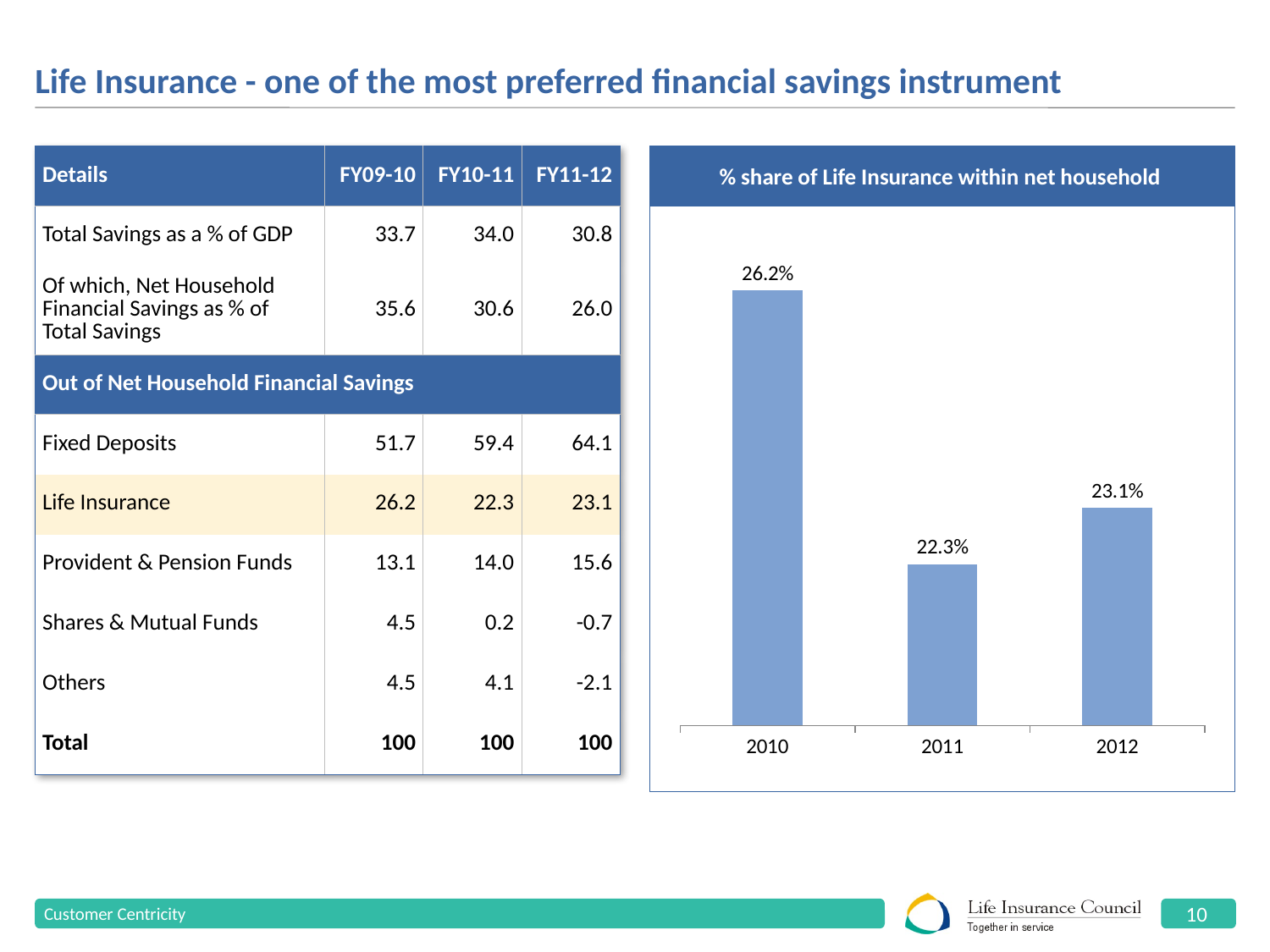
What is the difference between the 2012 and 2011 values in the chart? 0.8% Does the % share of Life Insurance rise or fall from 2010 to 2011? Fall Which year has the lowest % share of Life Insurance within net household? 2011 What is the % share of Life Insurance within net household in 2011? 22.3% How many years are shown in the chart? 3 Which year has the highest % share of Life Insurance within net household? 2010 What is the difference between the 2010 and 2011 values in the chart? 3.9% What is the title of the chart on the slide? % share of Life Insurance within net household What is the % share of Life Insurance within net household in 2010? 26.2% Which is larger in the chart, the value for 2010 or the value for 2012? 2010 What is the % share of Life Insurance within net household in 2012? 23.1% What kind of chart is shown on the slide? Bar chart